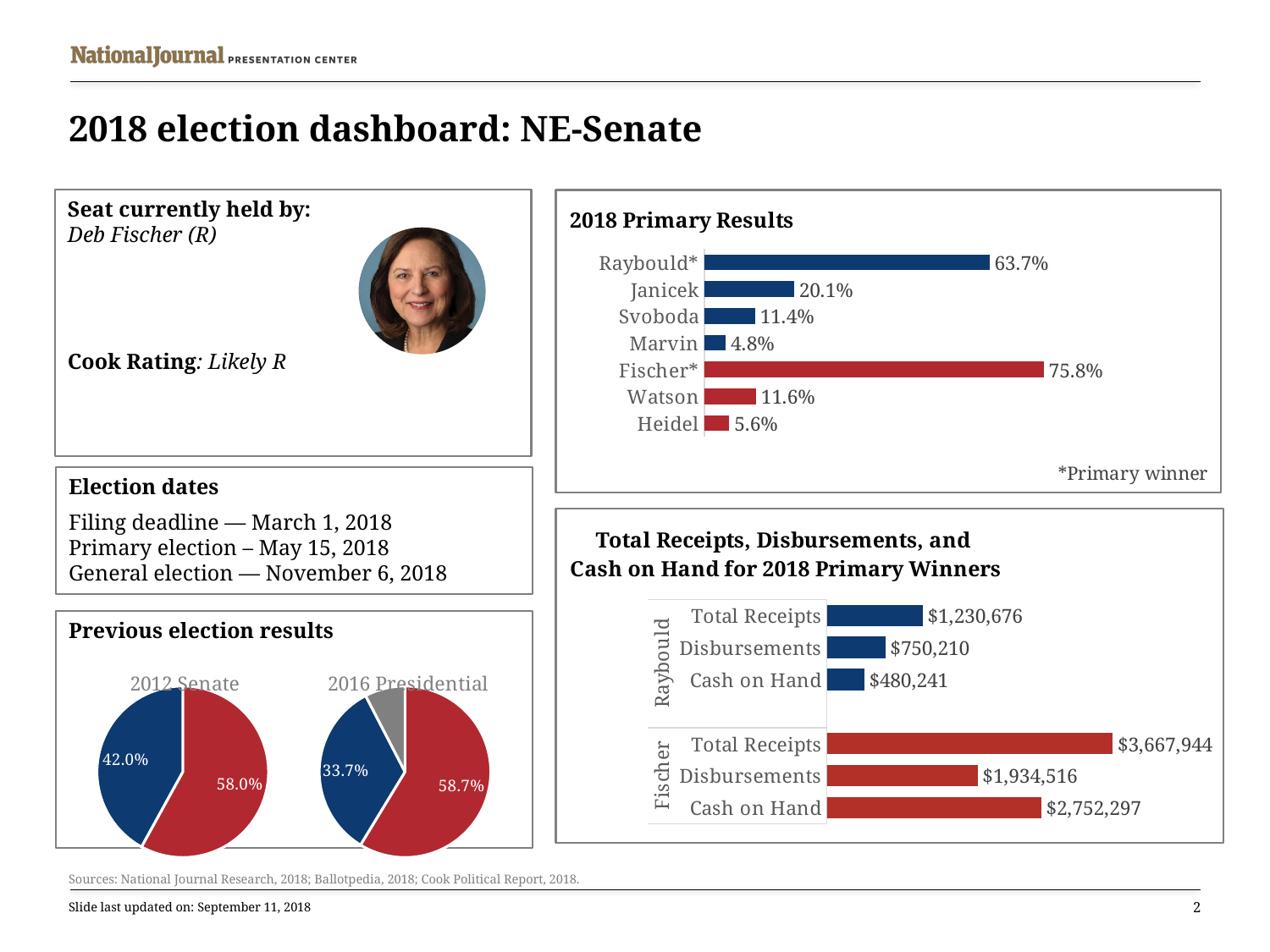
In the Total Receipts, Disbursements, and Cash on Hand chart, what is Fischer's Total Receipts value? $3,667,944 In the 2018 Primary Results chart, what percentage did Raybould* receive? 63.7% In the Total Receipts, Disbursements, and Cash on Hand chart, which is larger: Fischer's Disbursements or Fischer's Cash on Hand? Fischer's Cash on Hand In the Total Receipts, Disbursements, and Cash on Hand chart, what is Raybould's Cash on Hand value? $480,241 In the 2018 Primary Results chart, which candidate has the lowest percentage? Marvin In the 2018 Primary Results chart, how many candidates are shown? 7 In the 2018 Primary Results chart, what is the difference between Raybould*'s and Janicek's percentages? 43.6% In the Previous election results 2012 Senate pie chart, what is the share of the red slice? 58.0% In the 2018 Primary Results chart, which candidate has the highest percentage? Fischer* In the Previous election results 2016 Presidential pie chart, what is the share of the blue slice? 33.7% What kind of chart is the 2018 Primary Results chart? Bar chart In the 2018 Primary Results chart, what percentage did Fischer* receive? 75.8%